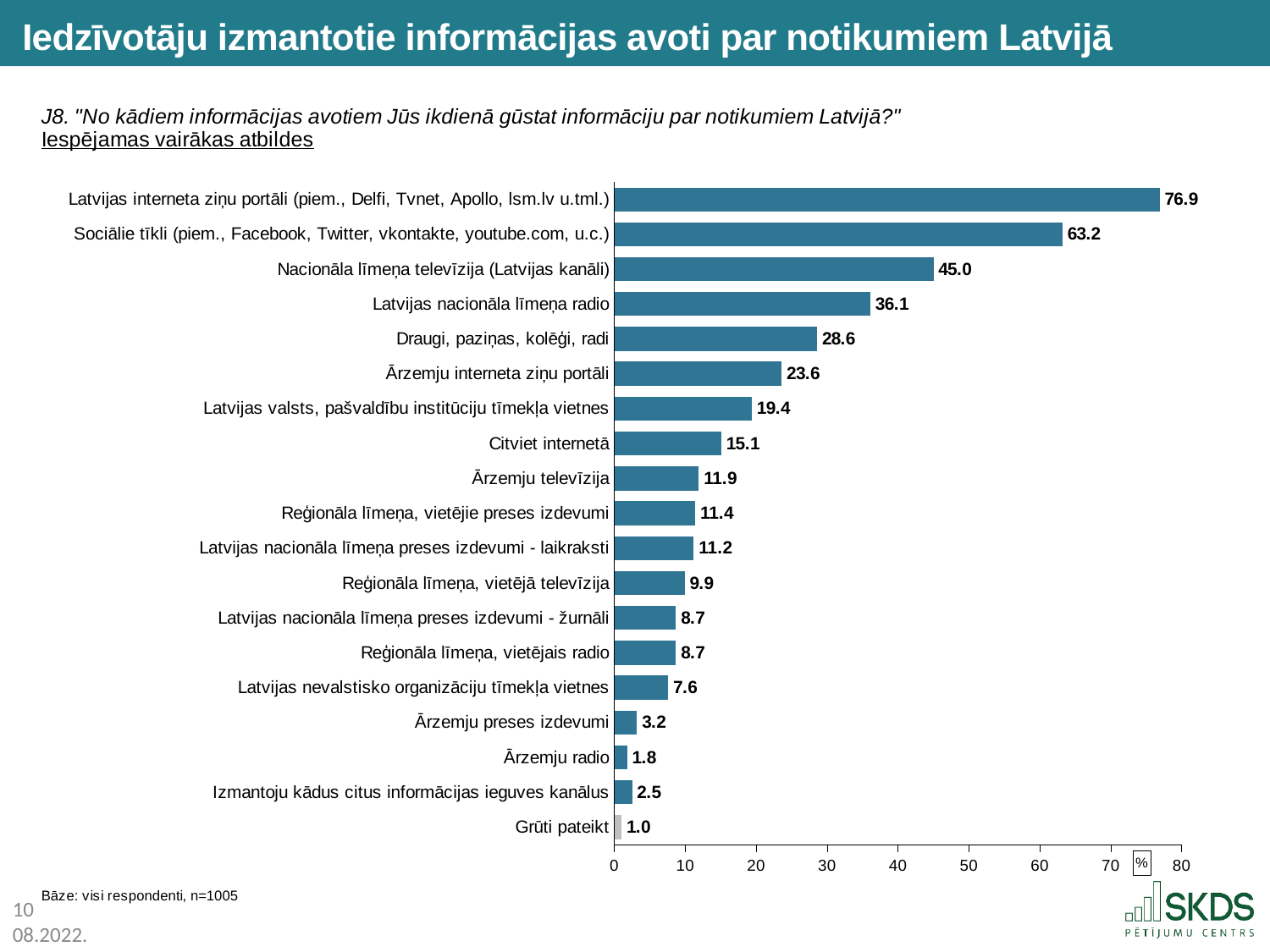
What is the value for Sociālie tīkli (piem., Facebook, Twitter, vkontakte, youtube.com, u.c.)? 63.2 What is the difference between the values for Latvijas interneta ziņu portāli and Sociālie tīkli? 13.7 Which is larger, the value for Ārzemju radio or the value for Izmantoju kādus citus informācijas ieguves kanālus? Izmantoju kādus citus informācijas ieguves kanālus How many categories are shown in the chart? 19 What kind of chart is shown on the slide? Bar chart What is the value for Ārzemju interneta ziņu portāli? 23.6 Which category has the lowest value? Grūti pateikt Which category has the highest value? Latvijas interneta ziņu portāli (piem., Delfi, Tvnet, Apollo, lsm.lv u.tml.) What is the difference between the values for Nacionāla līmeņa televīzija (Latvijas kanāli) and Latvijas nacionāla līmeņa radio? 8.9 What is the base (number of respondents) stated on the slide? n=1005 Which is larger, the value for Draugi, paziņas, kolēģi, radi or the value for Citviet internetā? Draugi, paziņas, kolēģi, radi What is the value for Latvijas nacionāla līmeņa radio? 36.1